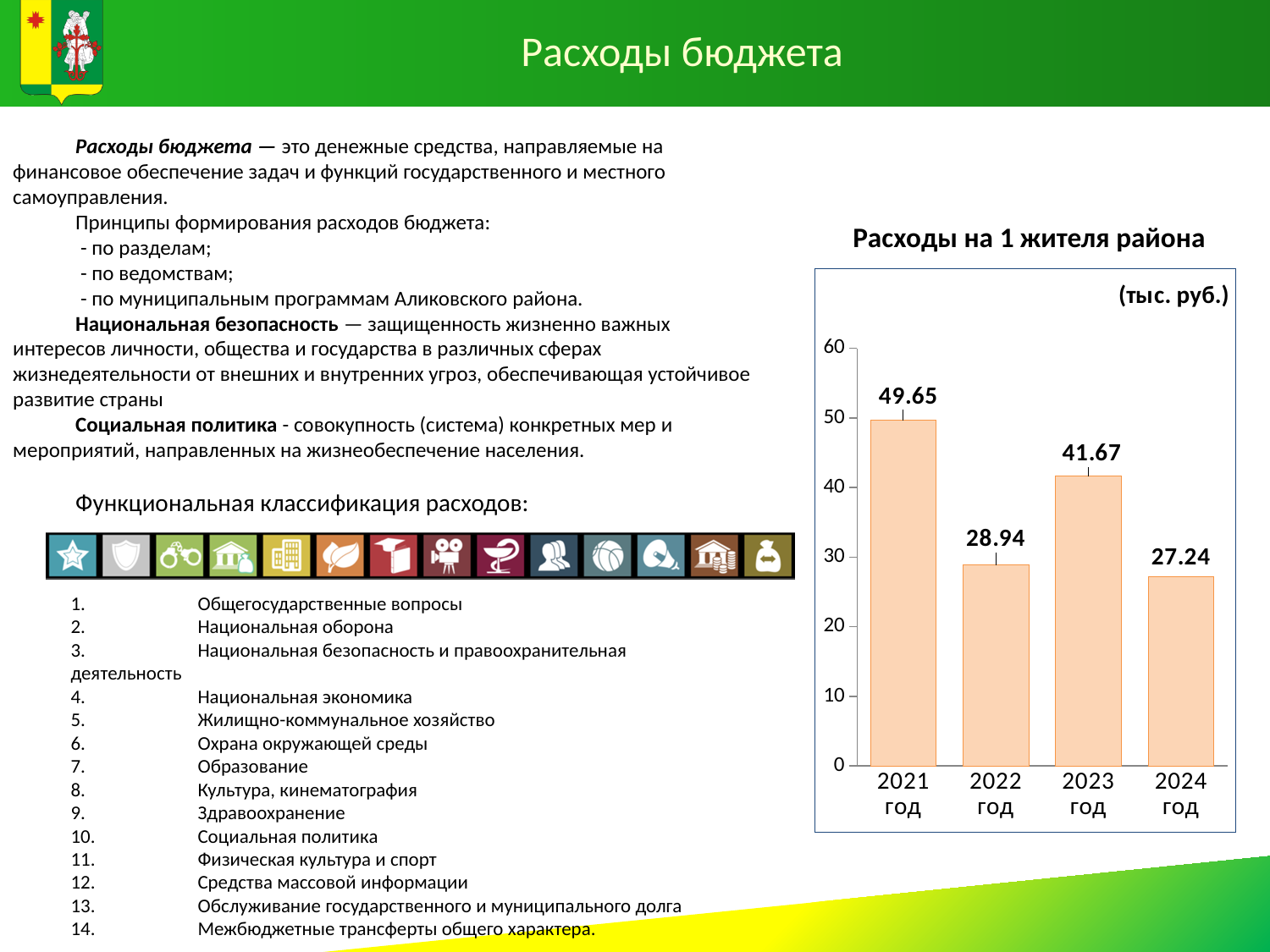
What type of chart is 'Расходы на 1 жителя района'? bar chart What unit is indicated in the chart 'Расходы на 1 жителя района'? тыс. руб. Is the value for 2022 год in the chart 'Расходы на 1 жителя района' greater or less than 30? less How many years are shown in the chart 'Расходы на 1 жителя района'? 4 What is the value for 2023 год in the chart 'Расходы на 1 жителя района'? 41.67 Which year has the lowest value in the chart 'Расходы на 1 жителя района'? 2024 год Which year has the highest value in the chart 'Расходы на 1 жителя района'? 2021 год What is the difference between the values for 2021 год and 2022 год in the chart 'Расходы на 1 жителя района'? 20.71 What is the value for 2024 год in the chart 'Расходы на 1 жителя района'? 27.24 What is the value for 2021 год in the chart 'Расходы на 1 жителя района'? 49.65 What is the difference between the values for 2023 год and 2024 год in the chart 'Расходы на 1 жителя района'? 14.43 Which is larger in the chart 'Расходы на 1 жителя района': the value for 2022 год or 2023 год? 2023 год